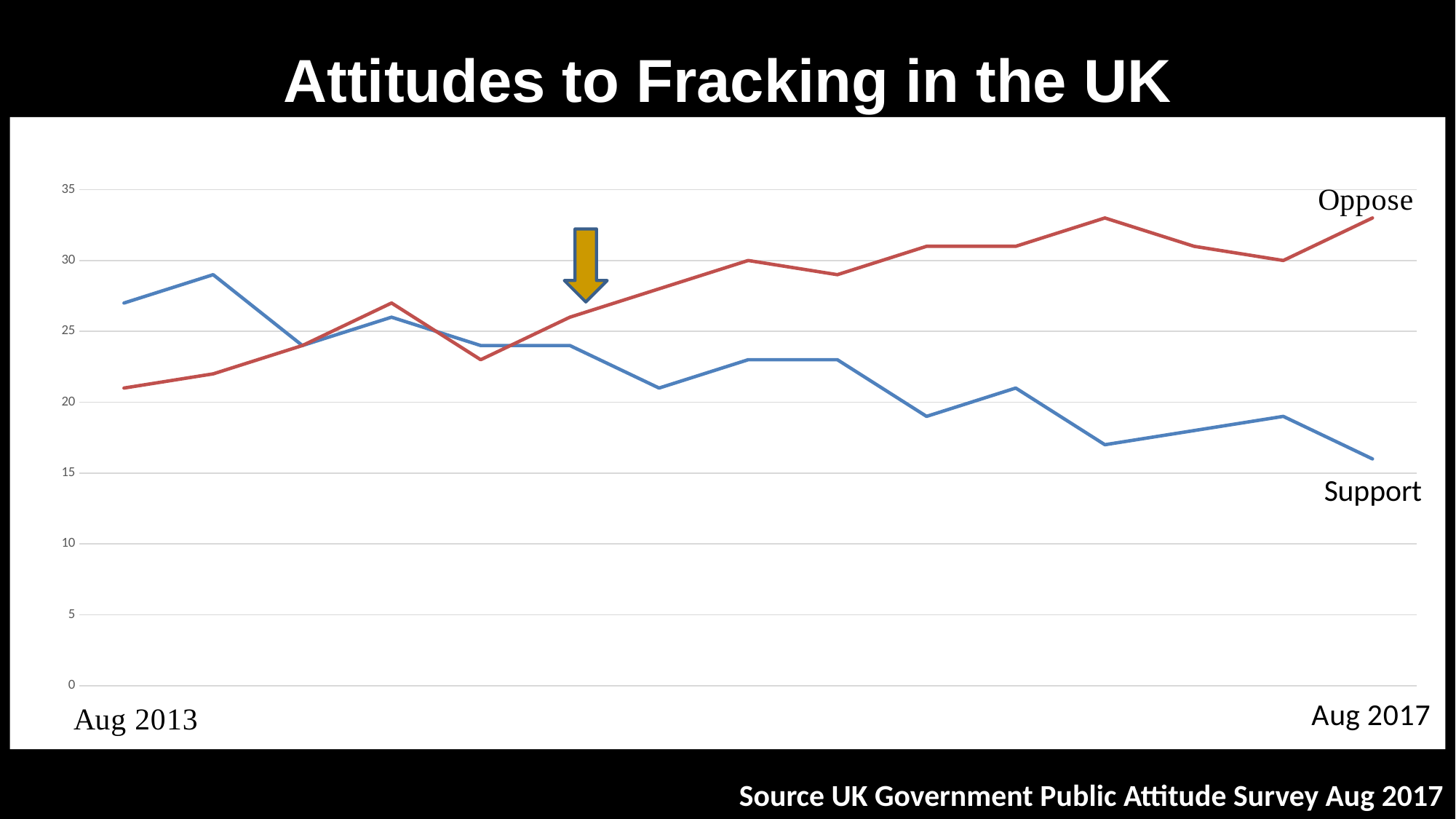
Is the value for Oppose at Aug 2017 greater or less than 30? greater Is the value for Support at Aug 2013 greater or less than 25? greater How many series are plotted on the chart? 2 What is the title of the chart? Attitudes to Fracking in the UK What are the names of the two series plotted on the chart? Oppose and Support At Aug 2013, which series is higher, Oppose or Support? Support What kind of chart is shown on the slide? line chart Does the Oppose line rise or fall overall from Aug 2013 to Aug 2017? rises Is the value for Support at Aug 2017 greater or less than 20? less Does the Support line rise or fall overall from Aug 2013 to Aug 2017? falls At Aug 2017, which series is higher, Oppose or Support? Oppose